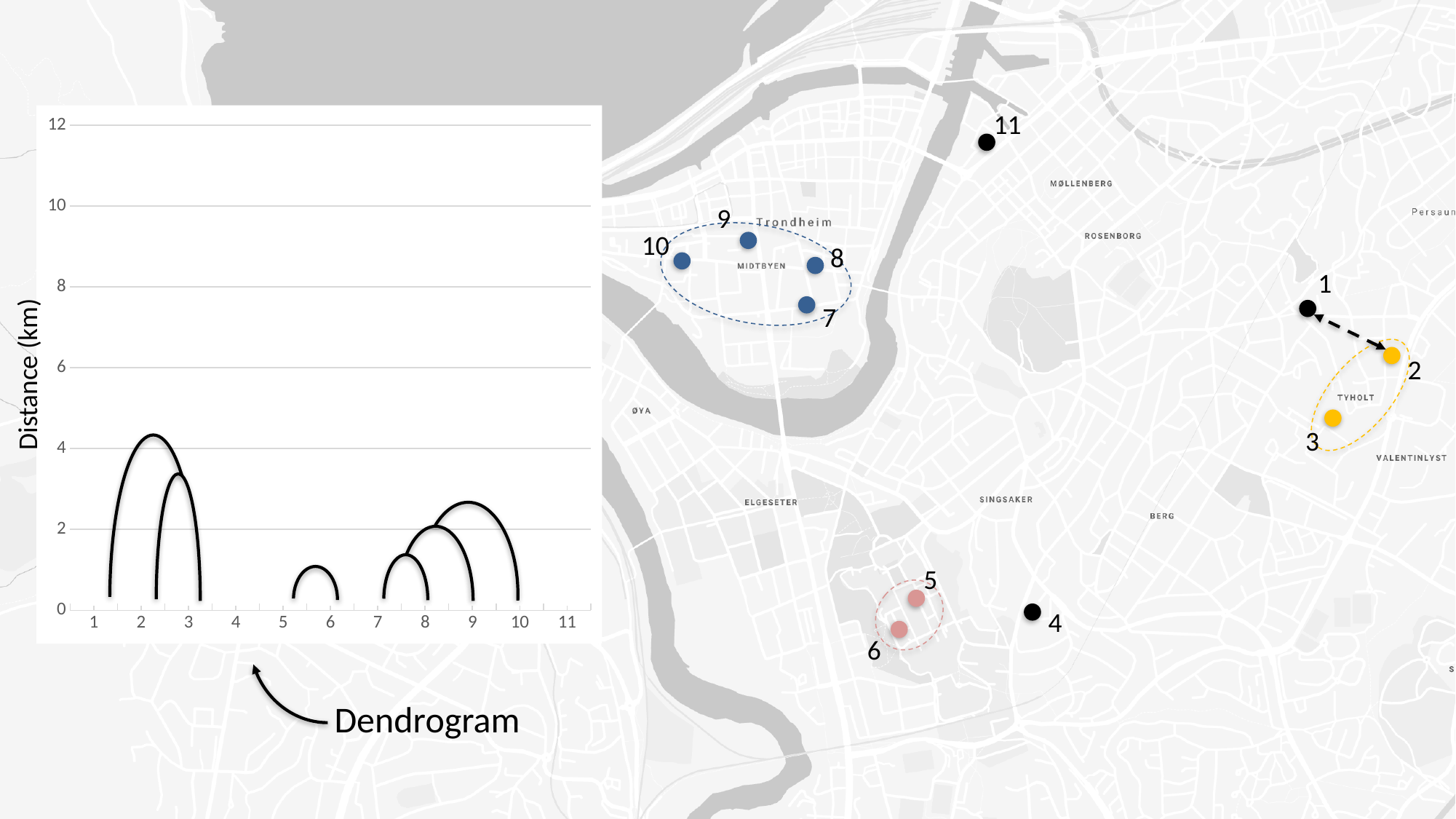
What kind of chart is shown on the left of the slide? dendrogram What word does the curved arrow annotation below the chart use to name it? Dendrogram Is the height of the arc that joins point 10 to the cluster of 7, 8 and 9 greater or less than 3? less Is the height of the arc joining points 2 and 3 in the dendrogram greater or less than 4? less Is the height of the arc joining points 5 and 6 in the dendrogram greater or less than 2? less Which arc in the dendrogram reaches the greatest distance: the one joining points 1 and 3, or the one joining point 10 to points 7, 8 and 9? the one joining points 1 and 3 How many numbered positions are labelled along the x-axis of the dendrogram? 11 Which merge in the dendrogram occurs at the greatest distance? the merge of point 1 with points 2 and 3 What is the label of the y-axis on the dendrogram? Distance (km) Which x-axis positions in the dendrogram are not joined by any arc? 4 and 11 What is the highest value shown on the y-axis of the dendrogram? 12